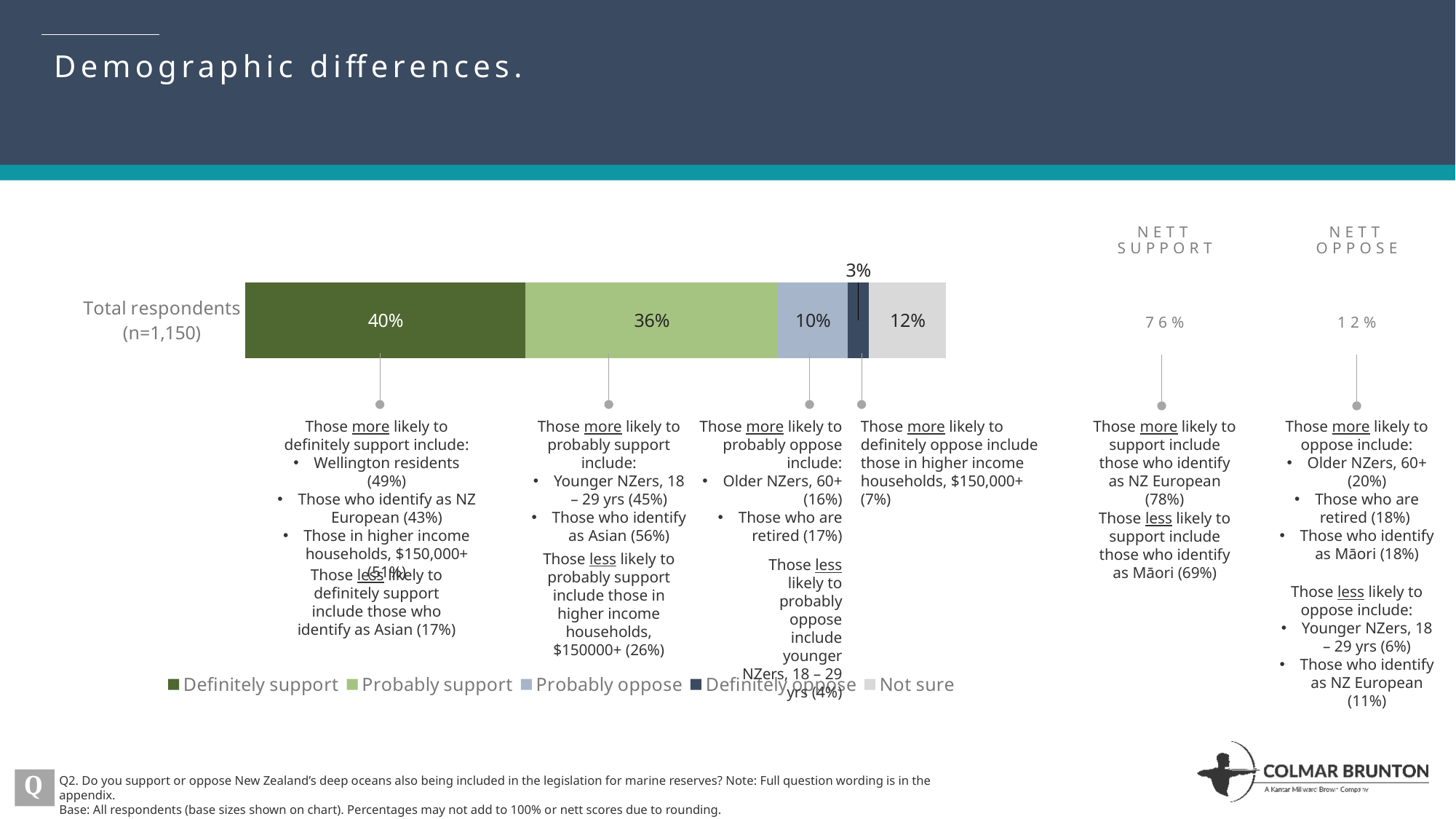
What percentage of total respondents said they probably oppose? 10% Which is larger for total respondents: 'Not sure' or 'Probably oppose'? Not sure What percentage of total respondents said they definitely support? 40% Which response category has the largest share of total respondents? Definitely support What is the difference in percentage points between 'Definitely support' and 'Probably support'? 4 What percentage of total respondents said they probably support? 36% What is the base size shown for total respondents? n=1,150 Which response category has the smallest share of total respondents? Definitely oppose What kind of chart is shown on the slide? Stacked bar chart What percentage of total respondents said they definitely oppose? 3% How many series does the legend list? 5 What percentage of total respondents said they were not sure? 12%